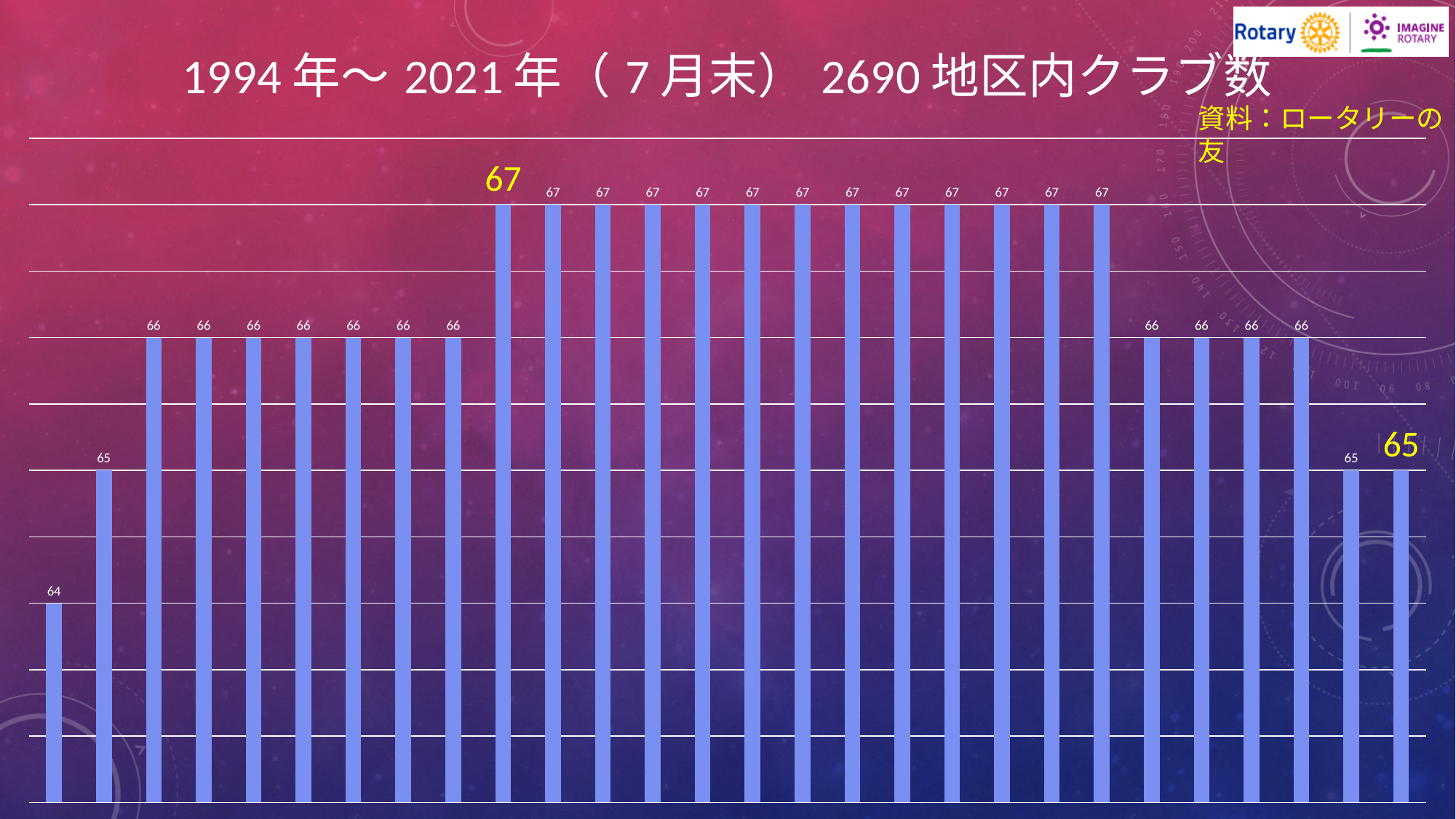
What kind of chart is shown on the slide? bar chart What is the value of the last (rightmost) bar? 65 What is the lowest value shown in the chart? 64 How many bars have the value 66? 11 What is the title of the chart? 1994年〜2021年（7月末） 2690地区内クラブ数 What is the highest value shown in the chart? 67 Do the values rise or fall from left to right across the chart overall? rise then fall How many bars have the value 67? 13 What is the difference between the highest and lowest values in the chart? 3 Which is larger, the value of the first bar or the value of the last bar? the last bar What is the value of the first (leftmost) bar? 64 How many bars are plotted in the chart? 28